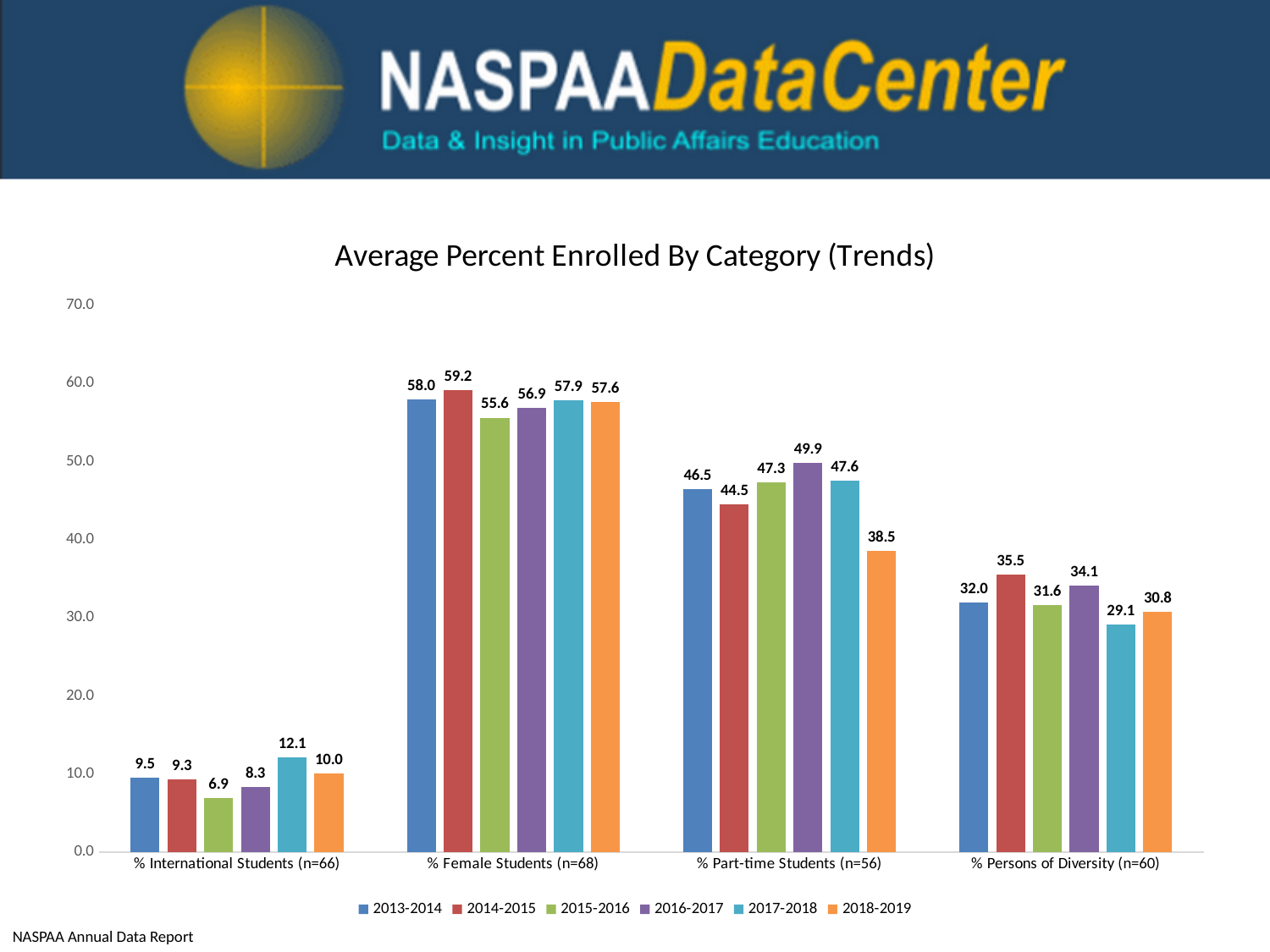
What is the value for % Persons of Diversity (n=60) in 2018-2019? 30.8 Which year has the lowest value for % International Students (n=66)? 2015-2016 Which is larger for % Persons of Diversity (n=60): the 2014-2015 value or the 2016-2017 value? 2014-2015 Which year has the lowest value for % Persons of Diversity (n=60)? 2017-2018 What is the title of the chart? Average Percent Enrolled By Category (Trends) How many categories are shown on the x axis? 4 What is the value for % International Students (n=66) in 2017-2018? 12.1 Which year has the highest value for % Part-time Students (n=56)? 2016-2017 What kind of chart is shown on the slide? Bar chart How many series does the legend list? 6 What is the value for % Female Students (n=68) in 2014-2015? 59.2 What is the difference between the 2016-2017 and 2018-2019 values for % Part-time Students (n=56)? 11.4